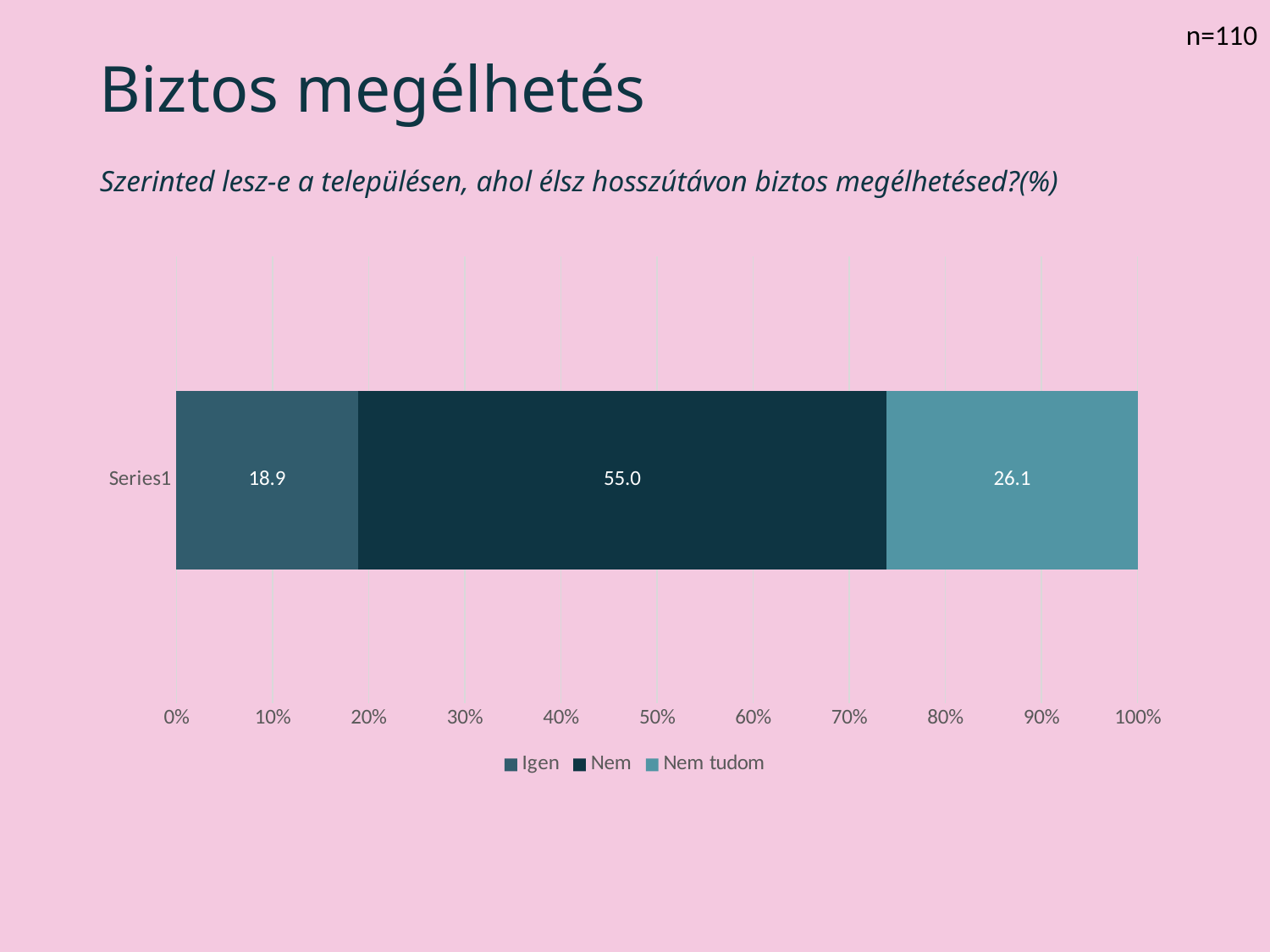
Which legend entry has the largest value in the bar? Nem Which legend entry has the smallest value in the bar? Igen What is the total of the three segments in the stacked bar? 100.0 Which is larger, the "Nem tudom" value or the "Igen" value? Nem tudom What kind of chart is shown on the slide? Stacked bar chart How many series does the legend list? 3 What is the value for the "Igen" segment of the stacked bar? 18.9 What is the sample size shown in the top right corner of the slide? n=110 What is the value for the "Nem tudom" segment of the stacked bar? 26.1 What is the difference between the "Nem tudom" value and the "Igen" value? 7.2 What is the difference between the "Nem" value and the "Igen" value? 36.1 What is the value for the "Nem" segment of the stacked bar? 55.0